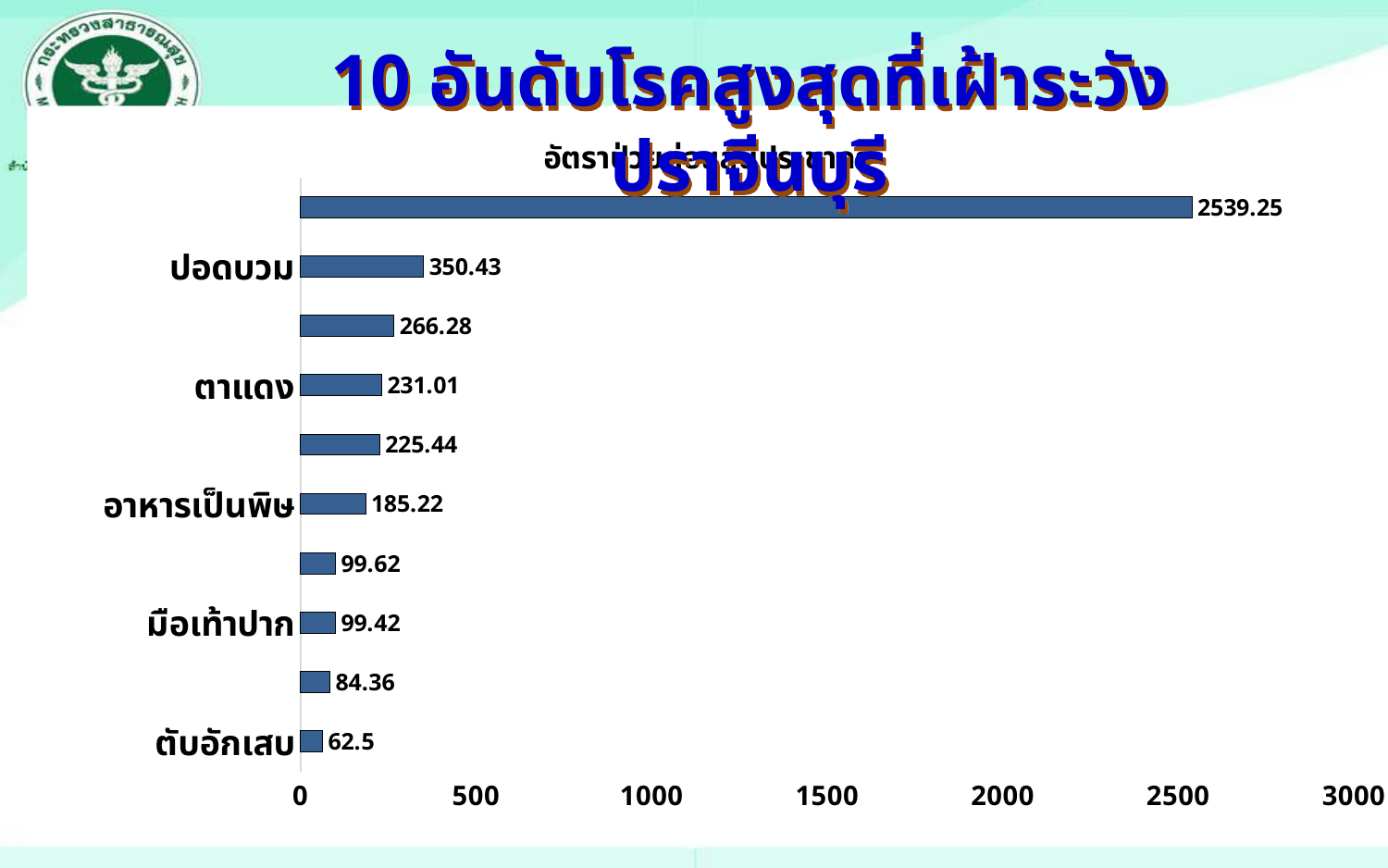
What is the difference between the values for ปอดบวม and ตาแดง? 119.42 What is the value for อาหารเป็นพิษ? 185.22 Which labelled category has the lowest value? ตับอักเสบ What is the maximum value shown on the horizontal axis? 3000 What is the largest value shown on the chart? 2539.25 What is the value for ตาแดง? 231.01 How many bars are plotted on the chart? 10 What is the value for ตับอักเสบ? 62.5 What kind of chart is shown on the slide? Bar chart What is the value for ปอดบวม? 350.43 What is the value for มือเท้าปาก? 99.42 Which is larger, the value for อาหารเป็นพิษ or the value for มือเท้าปาก? อาหารเป็นพิษ